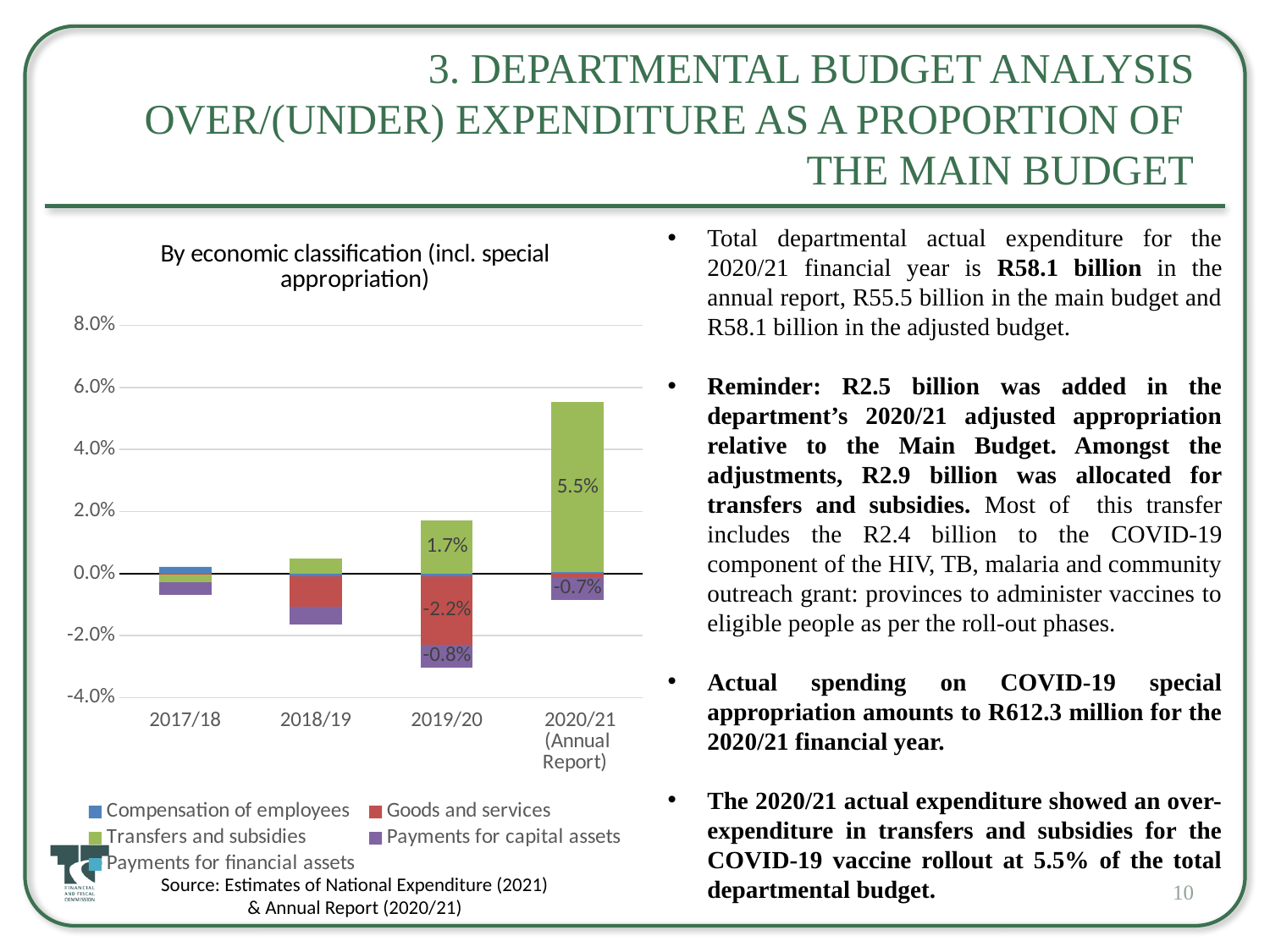
What is the value for Payments for capital assets in 2020/21 (Annual Report)? -0.7% What is the value for Goods and services in 2019/20? -2.2% How many financial years are shown on the x axis of the chart? 4 What is the value for Transfers and subsidies in 2020/21 (Annual Report)? 5.5% In which year is the Transfers and subsidies value the highest? 2020/21 (Annual Report) Is the value for Transfers and subsidies in 2020/21 (Annual Report) greater or less than 4.0%? greater What is the difference between the Transfers and subsidies values for 2020/21 (Annual Report) and 2019/20? 3.8 percentage points What is the title of the chart? By economic classification (incl. special appropriation) How many series does the chart's legend list? 5 What kind of chart is shown on the slide? Bar chart (stacked) What is the value for Payments for capital assets in 2019/20? -0.8% What is the value for Transfers and subsidies in 2019/20? 1.7%